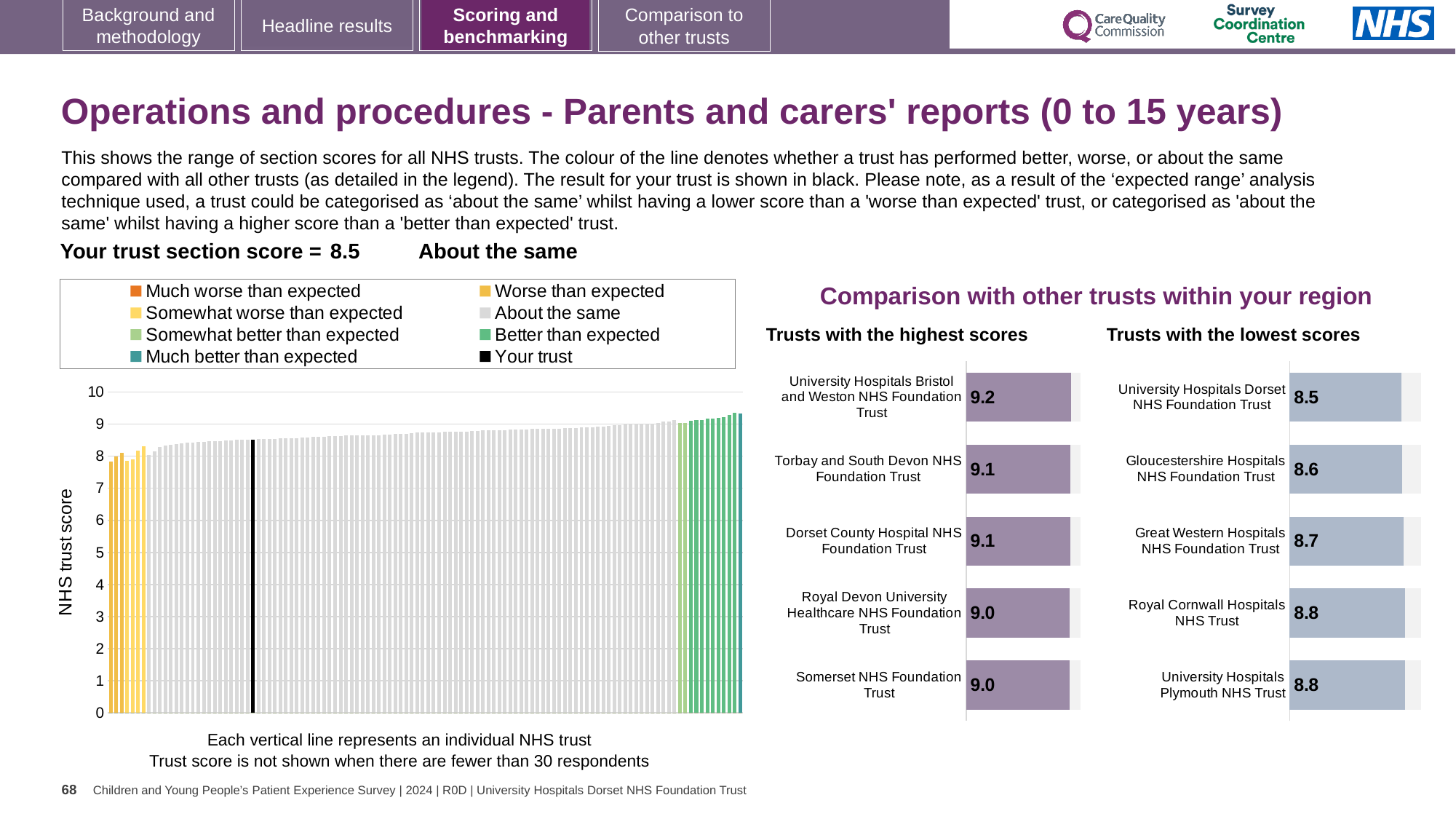
In the 'Trusts with the lowest scores' chart, what is the difference between the scores of University Hospitals Plymouth NHS Trust and University Hospitals Dorset NHS Foundation Trust? 0.3 How many trusts are listed in the 'Trusts with the lowest scores' chart? 5 In the 'Trusts with the lowest scores' chart, which trust has the lowest score? University Hospitals Dorset NHS Foundation Trust In the 'Trusts with the highest scores' chart, which trust has the highest score? University Hospitals Bristol and Weston NHS Foundation Trust What type of chart is the large chart on the left showing NHS trust scores? Bar chart In the 'Trusts with the highest scores' chart, what is the difference between the scores of University Hospitals Bristol and Weston NHS Foundation Trust and Somerset NHS Foundation Trust? 0.2 How many entries does the legend of the large chart on the left list? 8 In the 'Trusts with the lowest scores' chart, what is the score for Great Western Hospitals NHS Foundation Trust? 8.7 In the large chart on the left, do the trust scores rise or fall from left to right along the x axis? Rise What is the y-axis label of the large chart on the left? NHS trust score In the 'Trusts with the lowest scores' chart, which has the larger score: Gloucestershire Hospitals NHS Foundation Trust or Royal Cornwall Hospitals NHS Trust? Royal Cornwall Hospitals NHS Trust In the 'Trusts with the highest scores' chart, what is the score for University Hospitals Bristol and Weston NHS Foundation Trust? 9.2